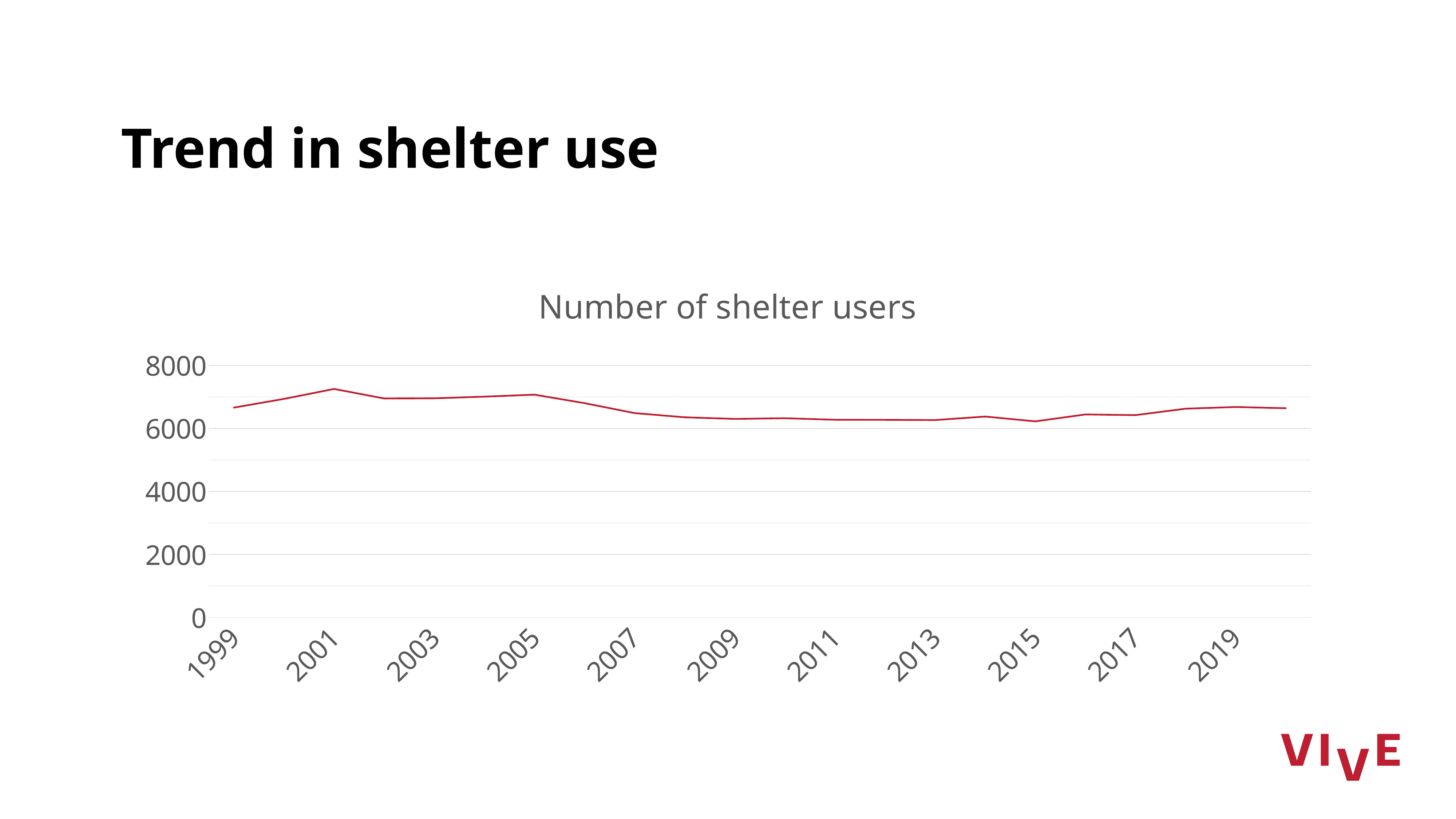
Which is larger, the value for 2005 or the value for 2015? 2005 How many year labels are shown on the x axis? 11 Which is larger, the value for 2001 or the value for 2009? 2001 Is the value for 2009 greater or less than 4000? greater Which year has the highest number of shelter users? 2001 Does the number of shelter users rise or fall between 2005 and 2009? fall What kind of chart is shown on the slide? line chart What is the title of the chart? Number of shelter users What is the highest value shown on the y axis? 8000 Is the value for 2015 greater or less than 8000? less Is the value for 2019 greater or less than 6000? greater